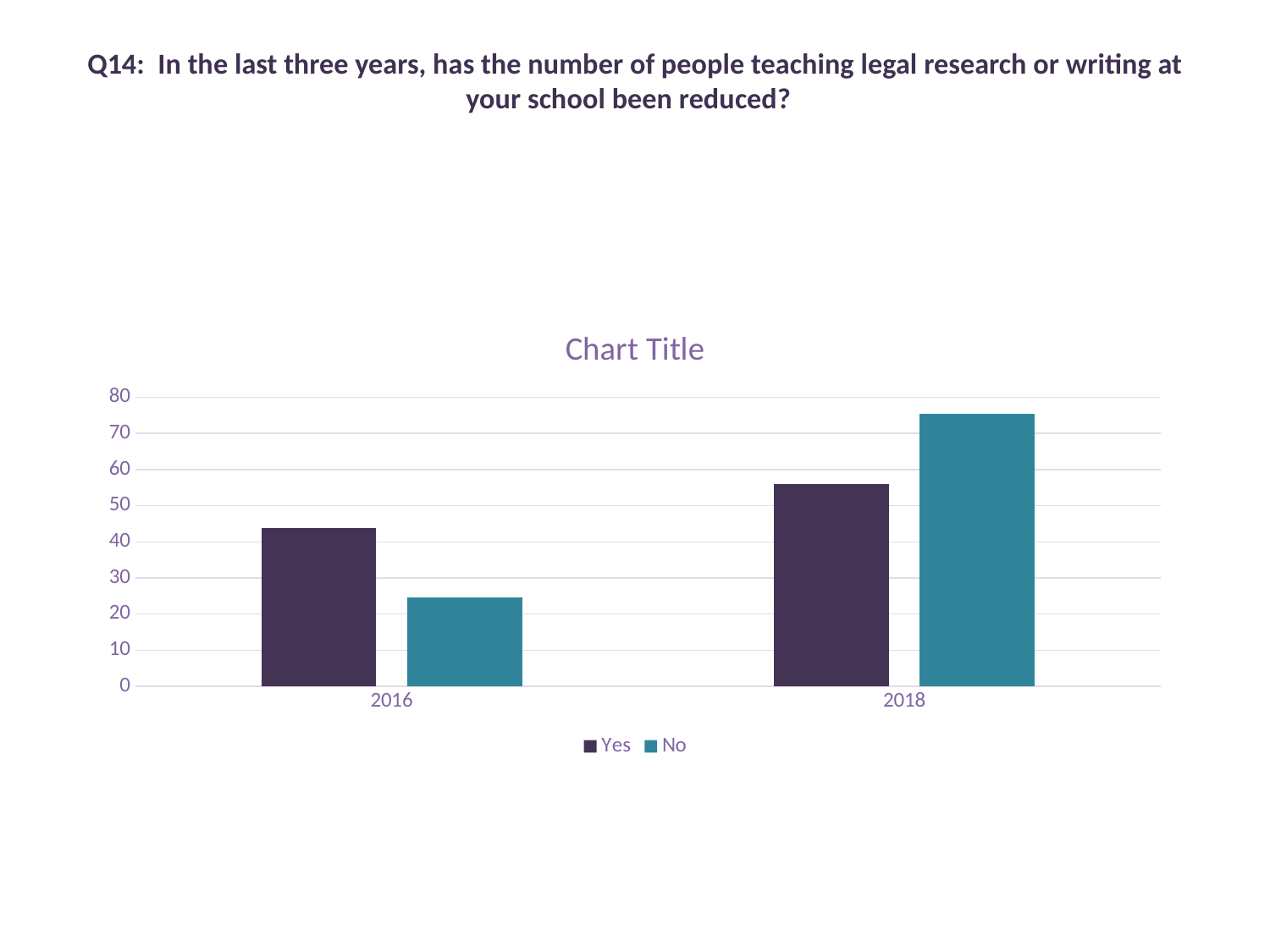
How many series does the legend list? 2 In 2016, which is larger, Yes or No? Yes What are the two entries in the chart's legend? Yes and No Is the value for Yes in 2018 greater or less than 50? greater Is the value for No in 2018 greater or less than 70? greater What kind of chart is shown on the slide? Bar chart How many year categories are shown on the x axis? 2 Does the value for No rise or fall from 2016 to 2018? Rise Is the value for Yes in 2016 greater or less than 40? greater Which bar is the highest in the chart? No in 2018 In 2018, which is larger, Yes or No? No